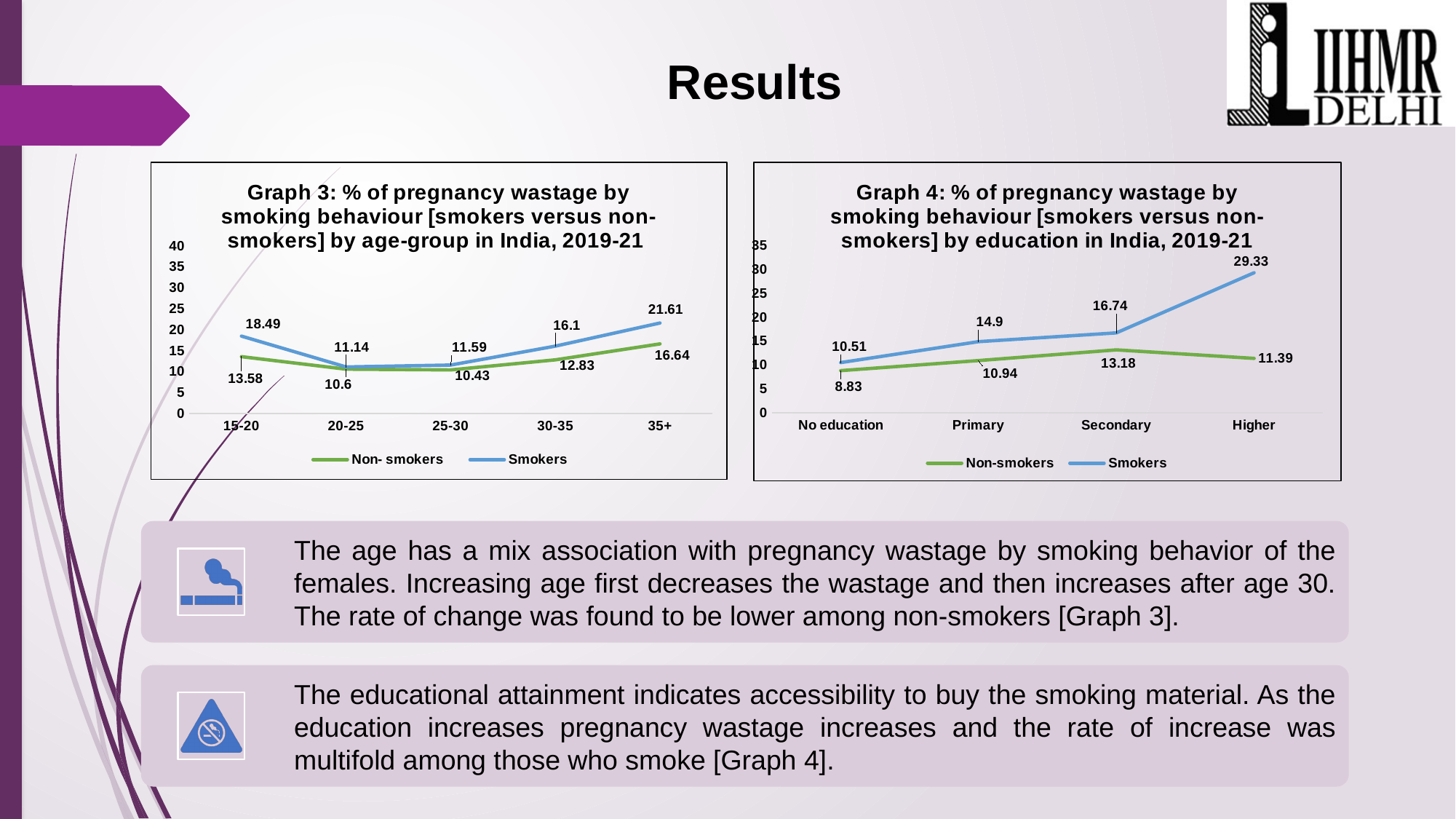
In Graph 3, what is the value for Smokers in the 35+ age group? 21.61 What type of chart is Graph 3? Line chart In Graph 3, what is the value for Non-smokers in the 25-30 age group? 10.43 In Graph 4, how many series does the legend list? 2 In Graph 3, how many age groups are shown on the x axis? 5 In Graph 4, what is the value for Smokers at the Higher education level? 29.33 In Graph 4, what is the difference between Smokers and Non-smokers at the Higher education level? 17.94 In Graph 4, which education level has the highest value for Smokers? Higher In Graph 3, which age group has the lowest value for Smokers? 20-25 In Graph 3, what is the difference between Smokers and Non-smokers in the 15-20 age group? 4.91 In Graph 4, which is larger at the Primary level, Smokers or Non-smokers? Smokers In Graph 4, what is the value for Non-smokers at the Secondary education level? 13.18